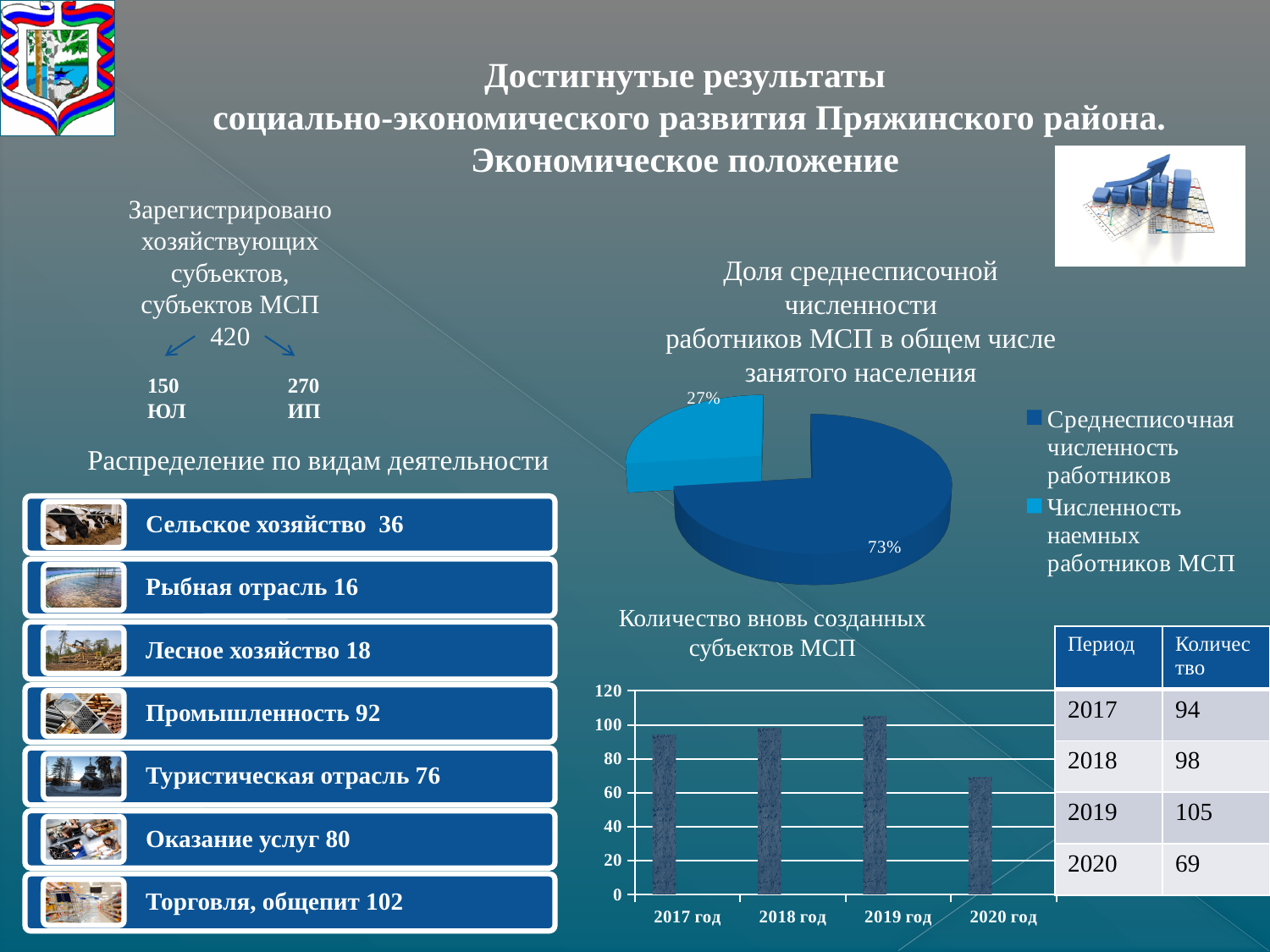
In the pie chart 'Доля среднесписочной численности работников МСП в общем числе занятого населения', what share is shown for 'Среднесписочная численность работников'? 73% What type of chart is 'Доля среднесписочной численности работников МСП в общем числе занятого населения'? pie chart In the pie chart 'Доля среднесписочной численности работников МСП в общем числе занятого населения', which slice is larger? Среднесписочная численность работников In the bar chart 'Количество вновь созданных субъектов МСП', is the value for 2020 год greater or less than 80? less In the bar chart 'Количество вновь созданных субъектов МСП', which year has the lowest bar? 2020 год How many entries does the legend of the pie chart 'Доля среднесписочной численности работников МСП в общем числе занятого населения' list? 2 In the pie chart 'Доля среднесписочной численности работников МСП в общем числе занятого населения', what share is shown for 'Численность наемных работников МСП'? 27% In the bar chart 'Количество вновь созданных субъектов МСП', which year has the highest bar? 2019 год What type of chart is 'Количество вновь созданных субъектов МСП'? bar chart In the bar chart 'Количество вновь созданных субъектов МСП', is the bar for 2018 год taller or shorter than the bar for 2020 год? taller How many categories are shown on the x axis of the bar chart 'Количество вновь созданных субъектов МСП'? 4 In the bar chart 'Количество вновь созданных субъектов МСП', is the value for 2019 год greater or less than 100? greater